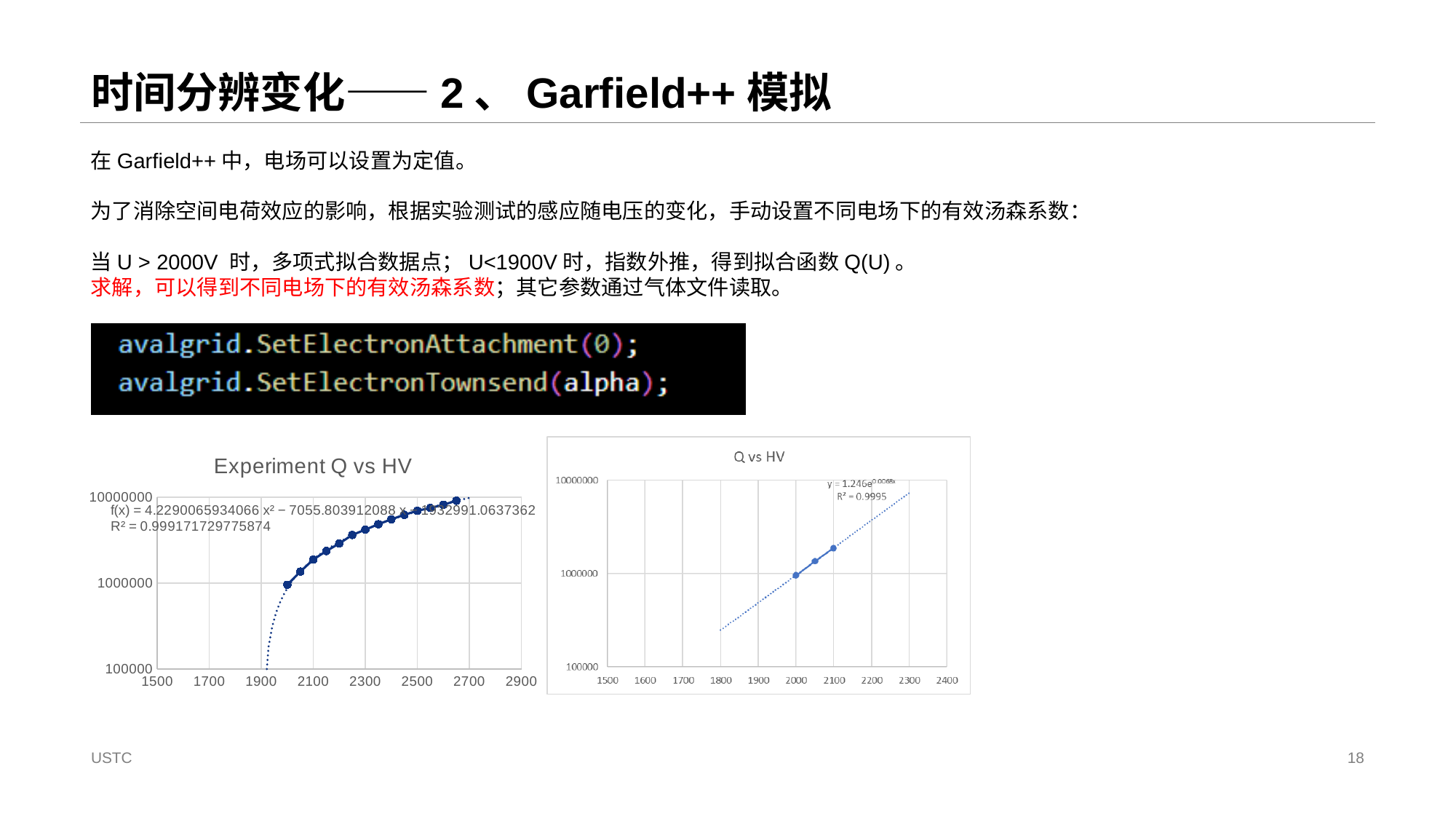
What kind of chart is the 'Experiment Q vs HV' chart on the left? Scatter chart with a fitted trend line In the 'Experiment Q vs HV' chart, is the value at HV = 2300 greater or less than 1000000? greater What is the title of the chart on the left of the slide? Experiment Q vs HV In the 'Q vs HV' chart on the right, which plotted point has the highest value: the one at HV = 2000 or the one at HV = 2100? HV = 2100 How many data points are plotted in the 'Q vs HV' chart on the right? 3 In the 'Experiment Q vs HV' chart, do the plotted values rise or fall as HV increases along the x axis? Rise In the 'Experiment Q vs HV' chart, what is the lowest x-axis tick label shown? 1500 In the 'Experiment Q vs HV' chart, is the highest plotted value greater or less than 10000000? less What is the R² value shown on the 'Q vs HV' chart on the right? R² = 0.9995 In the 'Q vs HV' chart on the right, do the plotted values rise or fall as HV increases along the x axis? Rise In the 'Q vs HV' chart on the right, what is the highest x-axis tick label shown? 2400 In the 'Q vs HV' chart on the right, is the value at HV = 2100 greater or less than 1000000? greater